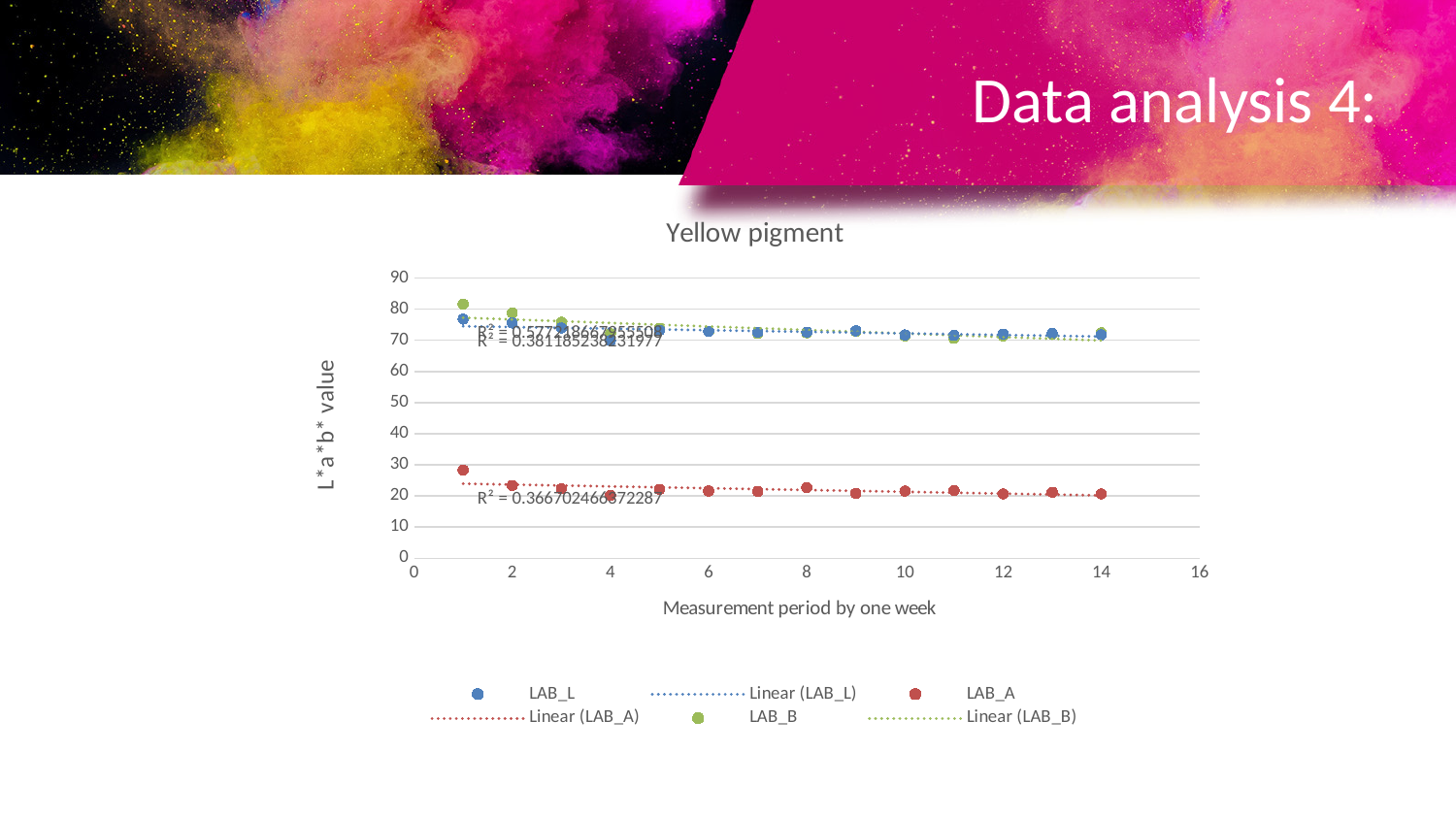
Which is larger at week 1, the LAB_L value or the LAB_A value? LAB_L Is the value for LAB_B at week 1 greater or less than 70? greater Do the LAB_B values rise or fall from week 1 to week 14? fall Which series has the highest value at week 1? LAB_B Is the value for LAB_A at week 14 greater or less than 30? less How many entries does the chart legend list? 6 What is the label of the x axis? Measurement period by one week What is the title of the chart? Yellow pigment Is the value for LAB_A at week 1 greater or less than 20? greater Which series has the lowest values throughout the measurement period? LAB_A What kind of chart is shown on the slide? Scatter chart